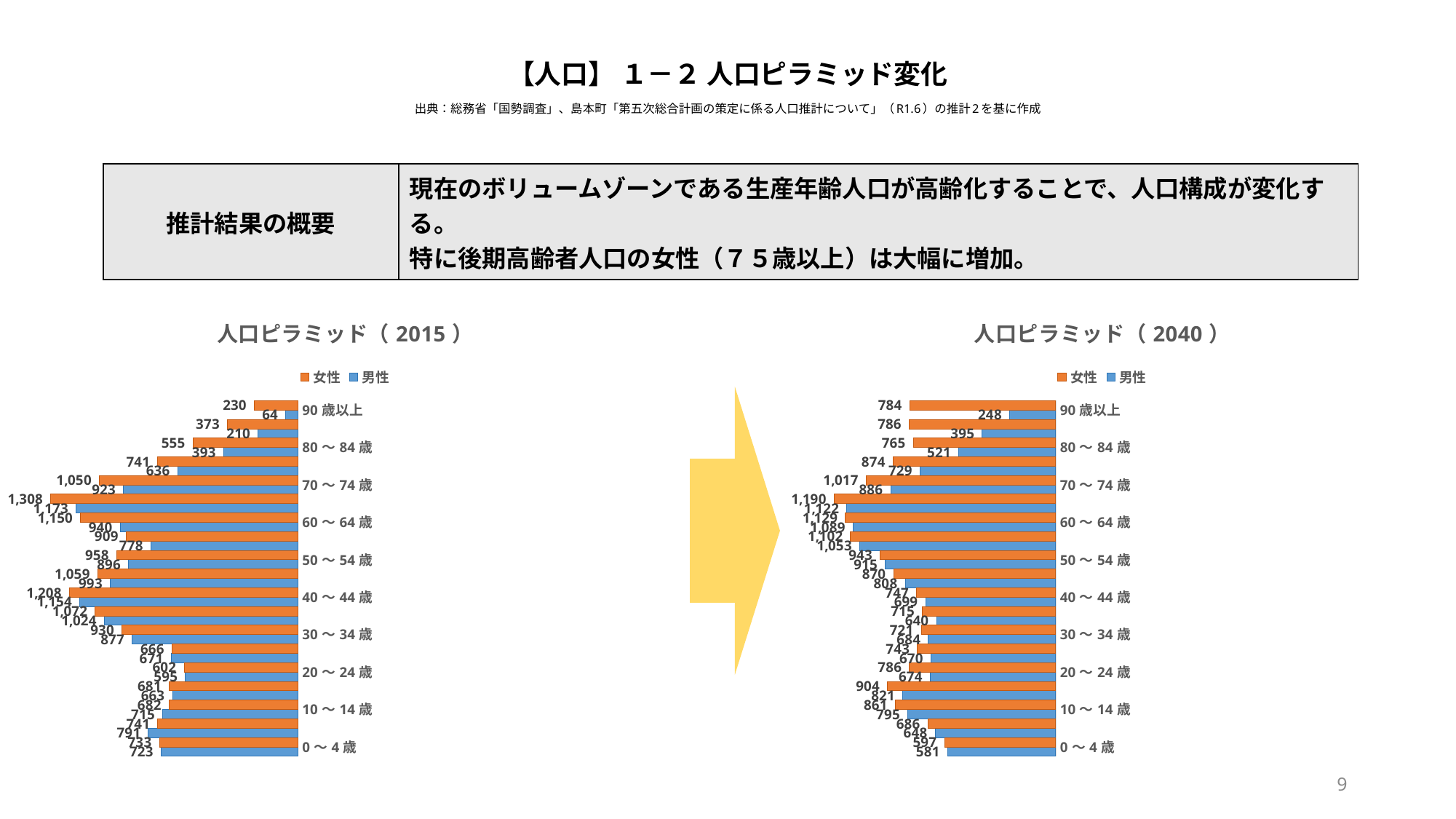
In the 人口ピラミッド（2040） chart, what is the 女性 value for 70～74歳? 1,017 In the 人口ピラミッド（2015） chart, what is the difference between the 女性 and 男性 values for 80～84歳? 162 In the 人口ピラミッド（2040） chart, what is the 男性 value for 80～84歳? 521 In the 人口ピラミッド（2040） chart, what is the 女性 value for 90歳以上? 784 In the 人口ピラミッド（2015） chart, what is the 女性 value for 70～74歳? 1,050 In the 人口ピラミッド（2040） chart, what is the difference between the 女性 and 男性 values for 90歳以上? 536 What kind of chart is the 人口ピラミッド（2015） chart? Bar chart In the 人口ピラミッド（2040） chart, which is larger for 20～24歳, the 女性 value or the 男性 value? 女性 How many series does the legend of the 人口ピラミッド（2040） chart list? 2 In the 人口ピラミッド（2015） chart, what is the largest 女性 value shown? 1,308 In the 人口ピラミッド（2015） chart, what is the 男性 value for 90歳以上? 64 In the 人口ピラミッド（2015） chart, what is the 女性 value for 90歳以上? 230